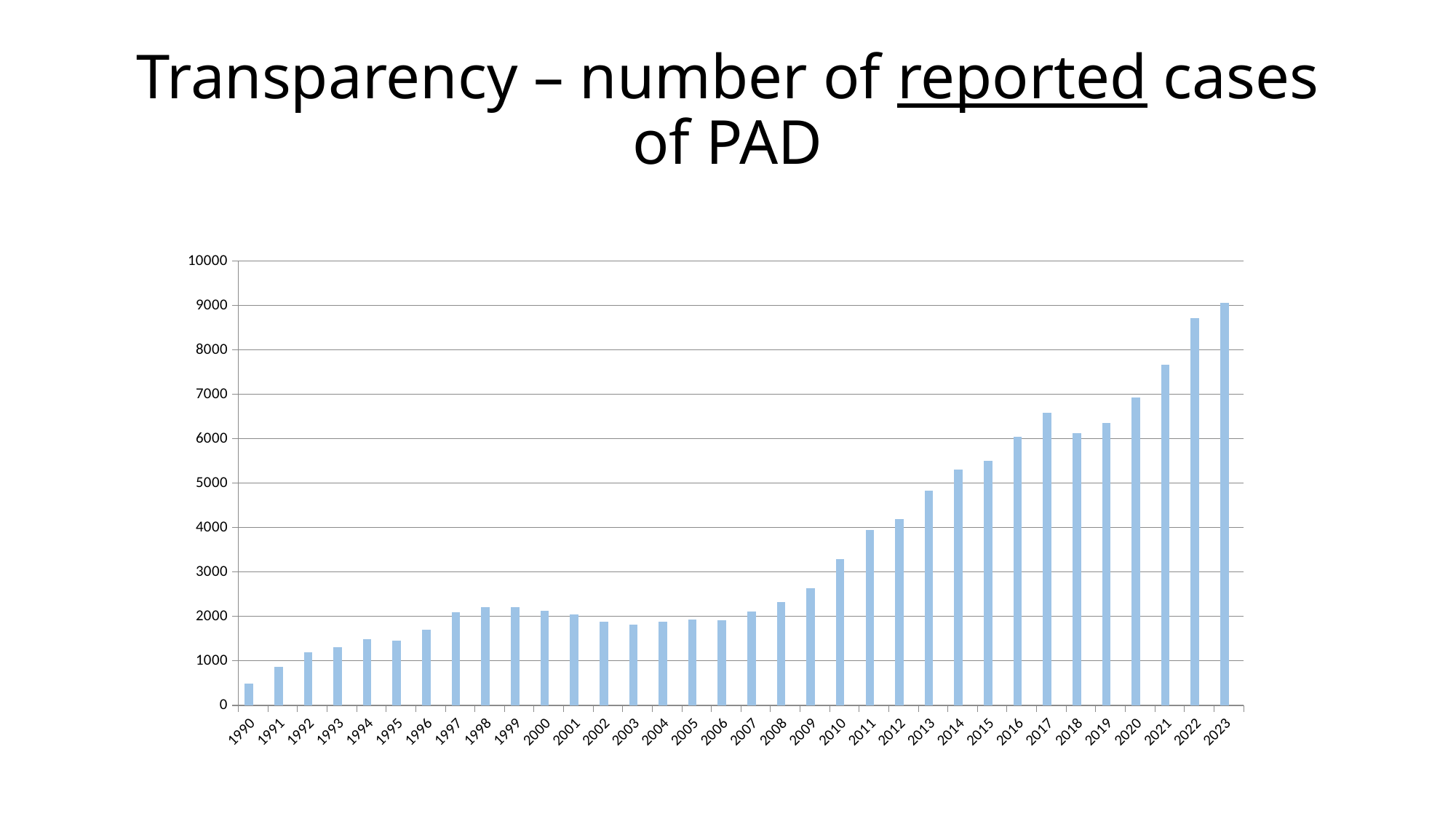
Is the value for 1990 greater or less than 1000? less Is the value for 2021 greater or less than 8000? less Overall, do the values rise or fall from 1990 to 2023? rise Which year has the larger value, 2017 or 2018? 2017 Is the value for 2009 greater or less than 3000? less Which year has the lowest number of reported cases of PAD? 1990 Which year has the highest number of reported cases of PAD? 2023 How many years (bars) are plotted on the chart? 34 What kind of chart is shown on the slide? bar chart What is the title of the slide containing the chart? Transparency – number of reported cases of PAD